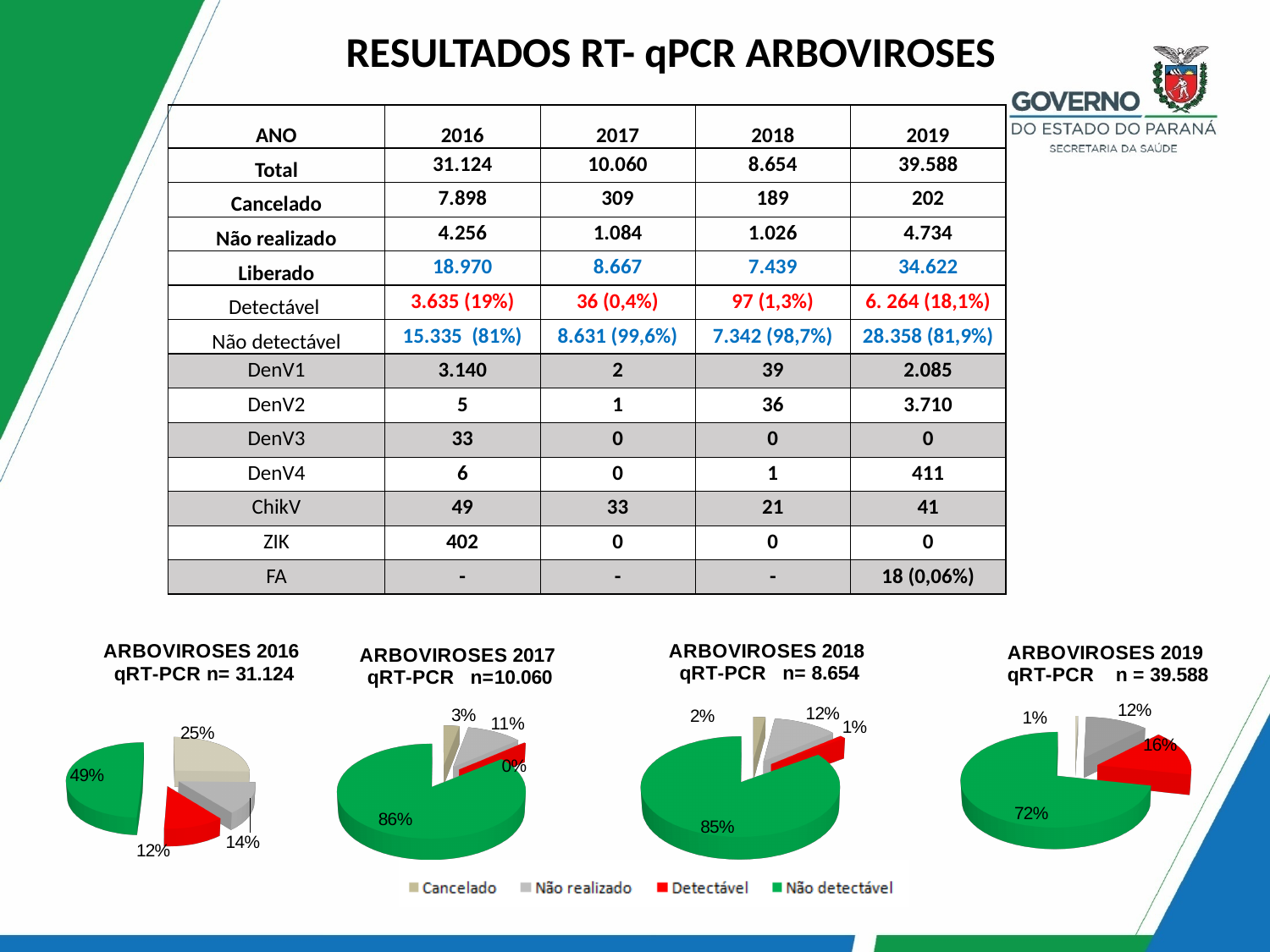
In the ARBOVIROSES 2016 pie chart, what is the difference between the Não detectável share and the Cancelado share? 24% In the ARBOVIROSES 2016 pie chart, what share is labelled for Cancelado? 25% In the ARBOVIROSES 2018 pie chart, which is larger, the Cancelado slice or the Não realizado slice? Não realizado In the ARBOVIROSES 2016 pie chart, what share is labelled for Não detectável? 49% In the ARBOVIROSES 2017 pie chart, what share is labelled for Não detectável? 86% What kind of chart is ARBOVIROSES 2017? Pie chart How many categories does the shared legend below the pie charts list? 4 In the ARBOVIROSES 2016 pie chart, which category has the smallest slice? Detectável What is the sample size (n) shown in the title of the ARBOVIROSES 2018 chart? 8.654 In the ARBOVIROSES 2019 pie chart, what share is labelled for Detectável? 16% In the ARBOVIROSES 2018 pie chart, what share is labelled for Não realizado? 12% In the ARBOVIROSES 2019 pie chart, which category has the largest slice? Não detectável